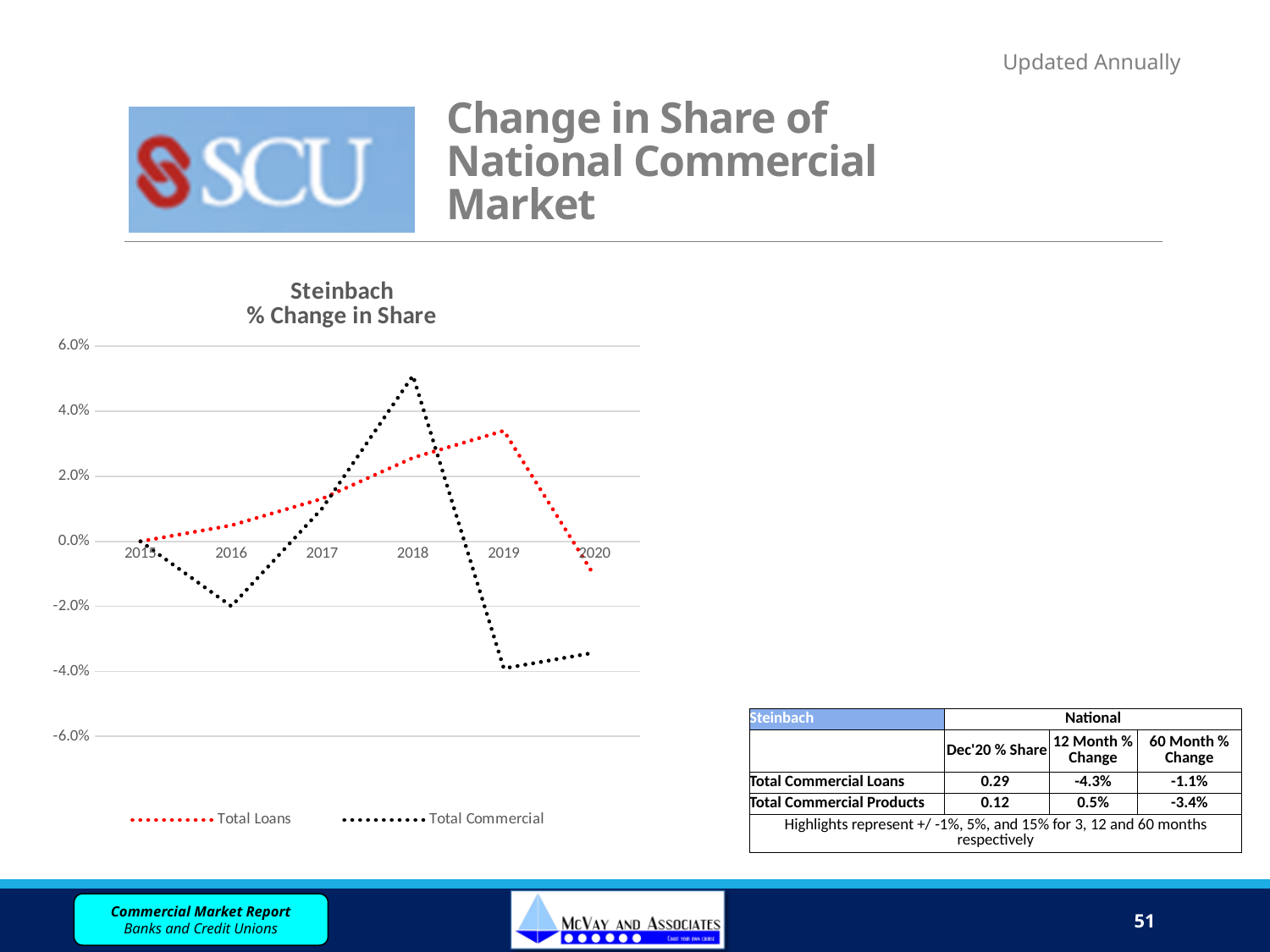
In which year does the Total Commercial series reach its highest value? 2018 How many series does the legend of the Steinbach % Change in Share chart list? 2 In which year does the Total Commercial series reach its lowest value? 2019 In 2018, which series has the higher value, Total Loans or Total Commercial? Total Commercial How many years are shown on the x axis of the Steinbach % Change in Share chart? 6 In 2019, which series has the higher value, Total Loans or Total Commercial? Total Loans Is the Total Commercial value for 2019 greater or less than -2.0%? less What colour is the Total Loans line in the Steinbach % Change in Share chart? red In which year does the Total Loans series reach its highest value? 2019 Is the Total Commercial value for 2018 greater or less than 4.0%? greater Is the Total Loans value for 2019 greater or less than 2.0%? greater What kind of chart is the Steinbach % Change in Share chart? line chart